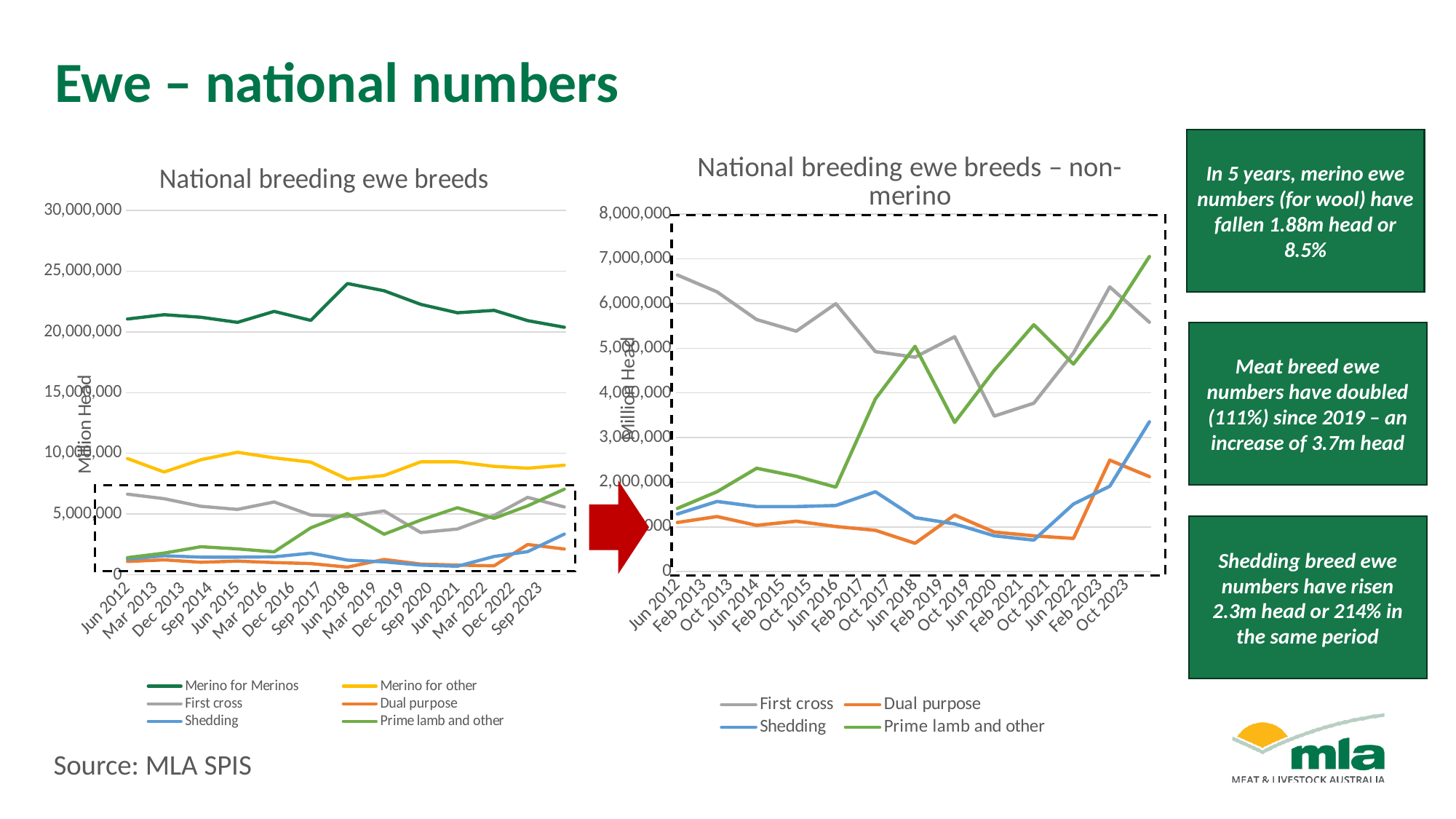
In the left chart 'National breeding ewe breeds', is the value for Merino for Merinos at Jun 2018 greater or less than 20,000,000? greater In the right chart 'National breeding ewe breeds – non-merino', is the value for Shedding at Oct 2023 greater or less than 3,000,000? greater In the right chart 'National breeding ewe breeds – non-merino', which series has the highest value at Oct 2023? Prime lamb and other How many series does the legend of the left chart 'National breeding ewe breeds' list? 6 In the right chart 'National breeding ewe breeds – non-merino', is the value for Prime lamb and other at Oct 2023 greater or less than 6,000,000? greater In the right chart 'National breeding ewe breeds – non-merino', does the First cross series rise or fall from Jun 2012 to Jun 2020? fall What kind of chart is the 'National breeding ewe breeds' chart on the left? line chart In the right chart 'National breeding ewe breeds – non-merino', at Jun 2012 which is larger, First cross or Prime lamb and other? First cross In the left chart 'National breeding ewe breeds', which series has the highest values throughout the period? Merino for Merinos How many series does the legend of the right chart 'National breeding ewe breeds – non-merino' list? 4 What is the y-axis label on the right chart 'National breeding ewe breeds – non-merino'? Million Head